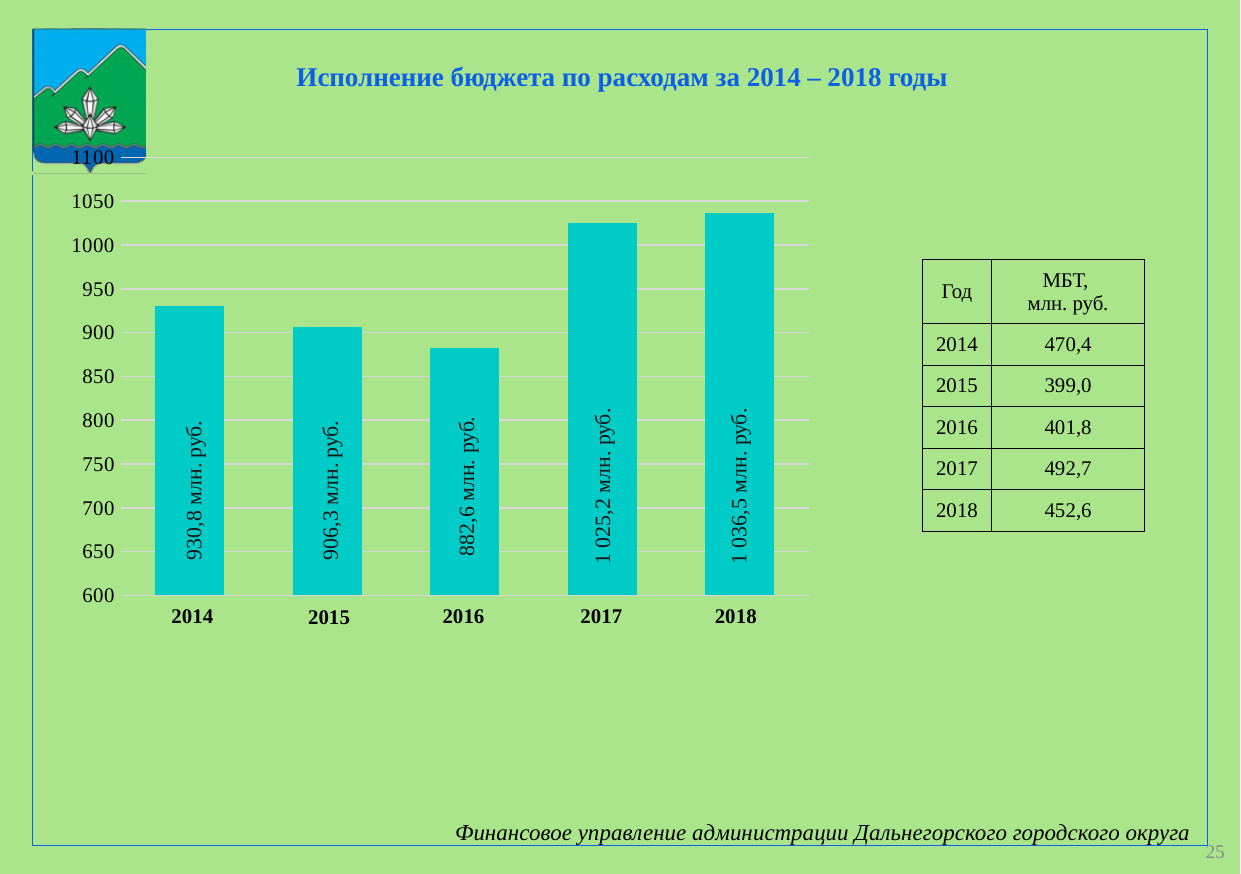
What is the difference between the values for 2018 and 2017? 11,3 млн. руб. What is the difference between the values for 2014 and 2015? 24,5 млн. руб. What is the value of the bar for 2014? 930,8 млн. руб. Which is larger, the value for 2015 or the value for 2016? 2015 Is the value for 2017 greater or less than 1000? greater Which year has the lowest bar? 2016 What is the title of the chart? Исполнение бюджета по расходам за 2014 – 2018 годы How many bars are shown in the chart? 5 Which year has the highest bar? 2018 What is the value of the bar for 2016? 882,6 млн. руб. What kind of chart is shown on the slide? bar chart What is the value of the bar for 2018? 1 036,5 млн. руб.